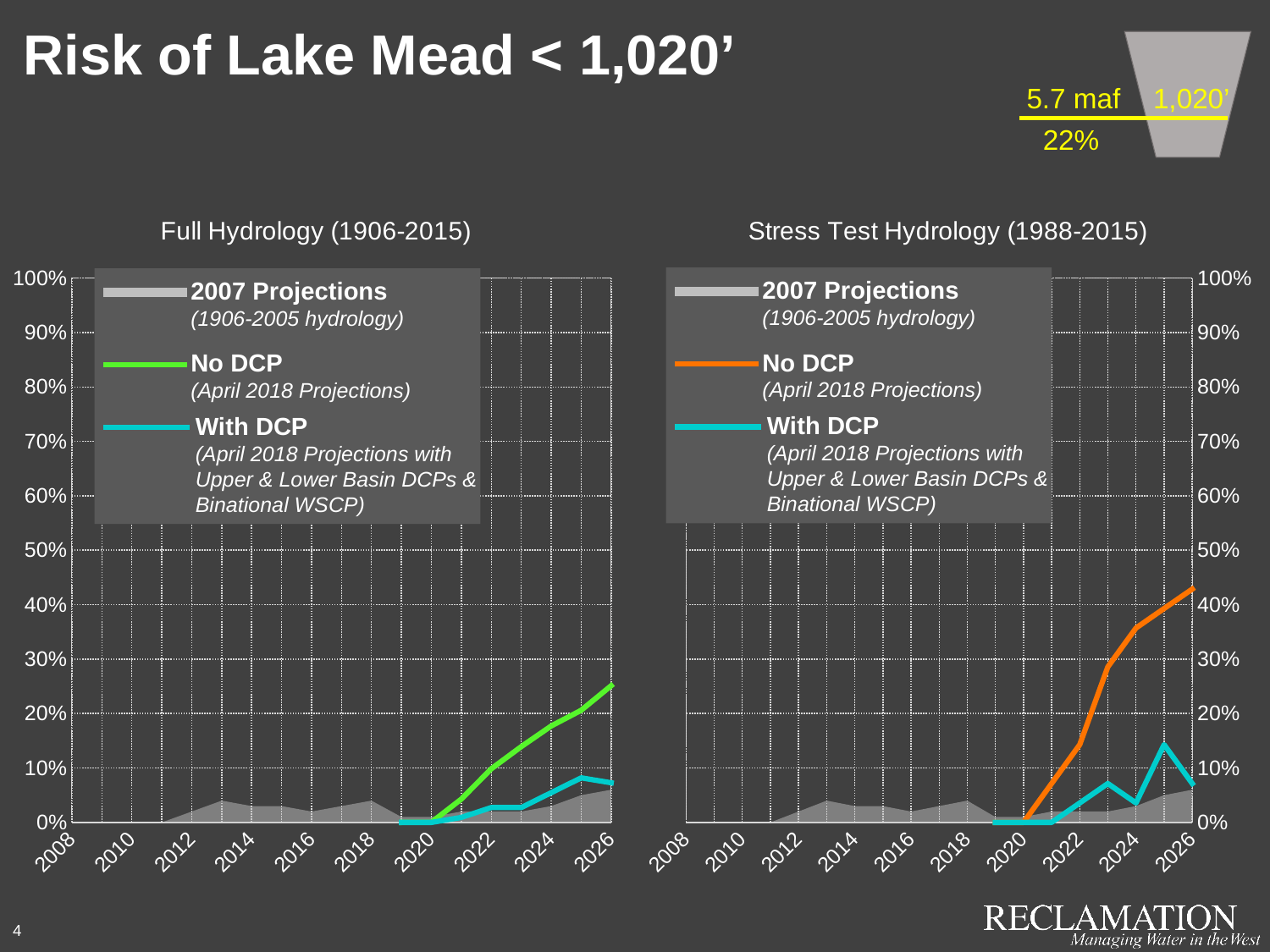
In the Stress Test Hydrology (1988-2015) chart, is the No DCP value in 2024 greater or less than 30%? greater In the Full Hydrology (1906-2015) chart, is the No DCP value in 2026 greater or less than 20%? greater In the Stress Test Hydrology (1988-2015) chart, does the No DCP series rise or fall from 2020 to 2026? rise In the Stress Test Hydrology (1988-2015) chart, which series is higher in 2026, No DCP or 2007 Projections? No DCP In the Full Hydrology (1906-2015) chart, is the With DCP value in 2026 greater or less than 10%? less How many series does the legend of the Stress Test Hydrology (1988-2015) chart list? 3 What is the title of the chart on the left side of the slide? Full Hydrology (1906-2015) What kind of chart is the Full Hydrology (1906-2015) chart? combination area and line chart In the Stress Test Hydrology (1988-2015) chart, what colour is the No DCP line? orange In the Full Hydrology (1906-2015) chart, which series is higher in 2026, No DCP or With DCP? No DCP